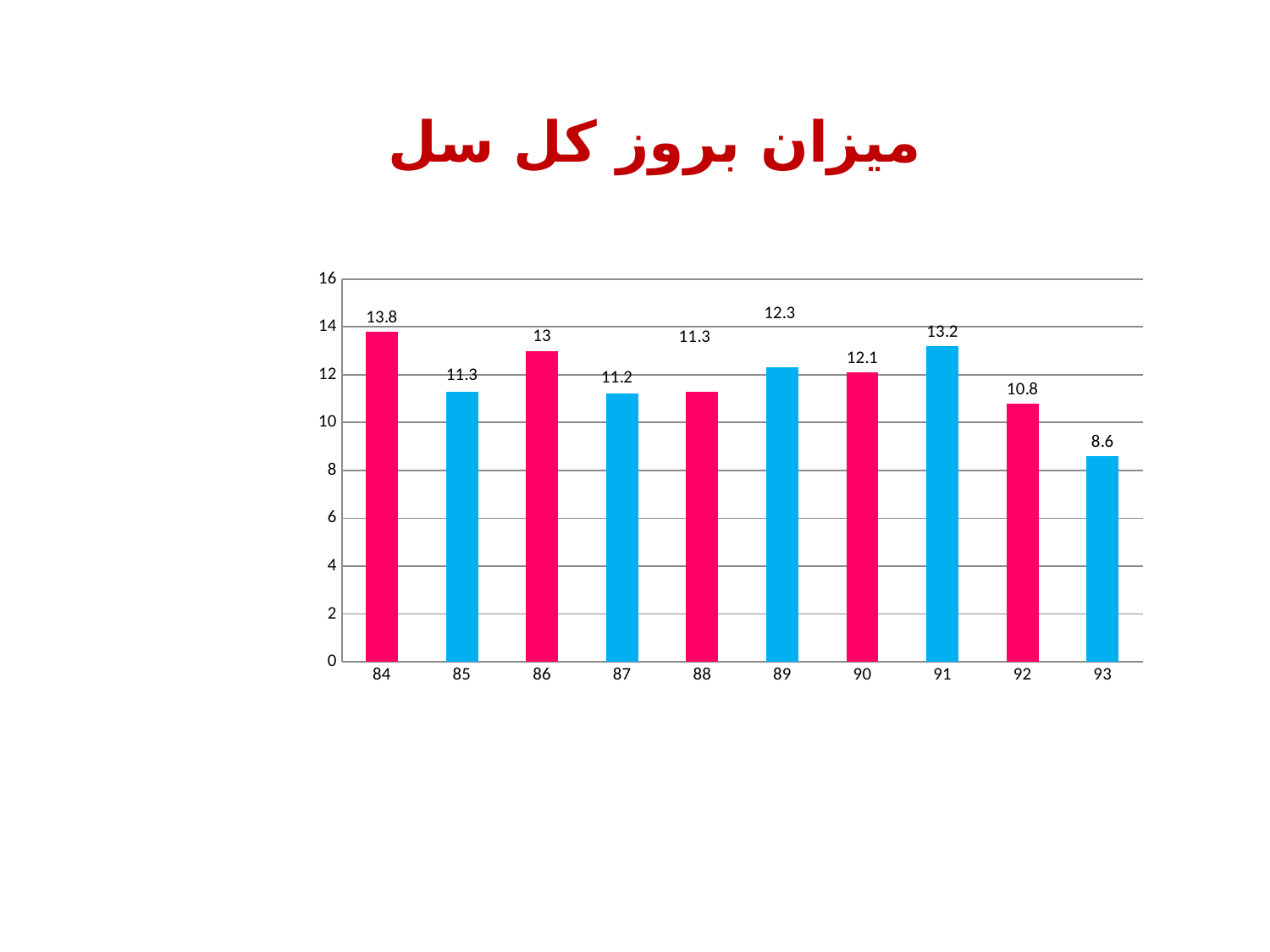
How many categories are shown on the x axis? 10 What is the value for 93? 8.6 What is the value for 92? 10.8 What is the value for 84? 13.8 What is the difference between the values for 84 and 93? 5.2 What is the difference between the values for 91 and 92? 2.4 Which category has the highest value? 84 What is the value for 89? 12.3 Which is larger, the value for 86 or the value for 90? 86 What is the title of the chart on the slide? میزان بروز کل سل Which category has the lowest value? 93 What kind of chart is this? Bar chart